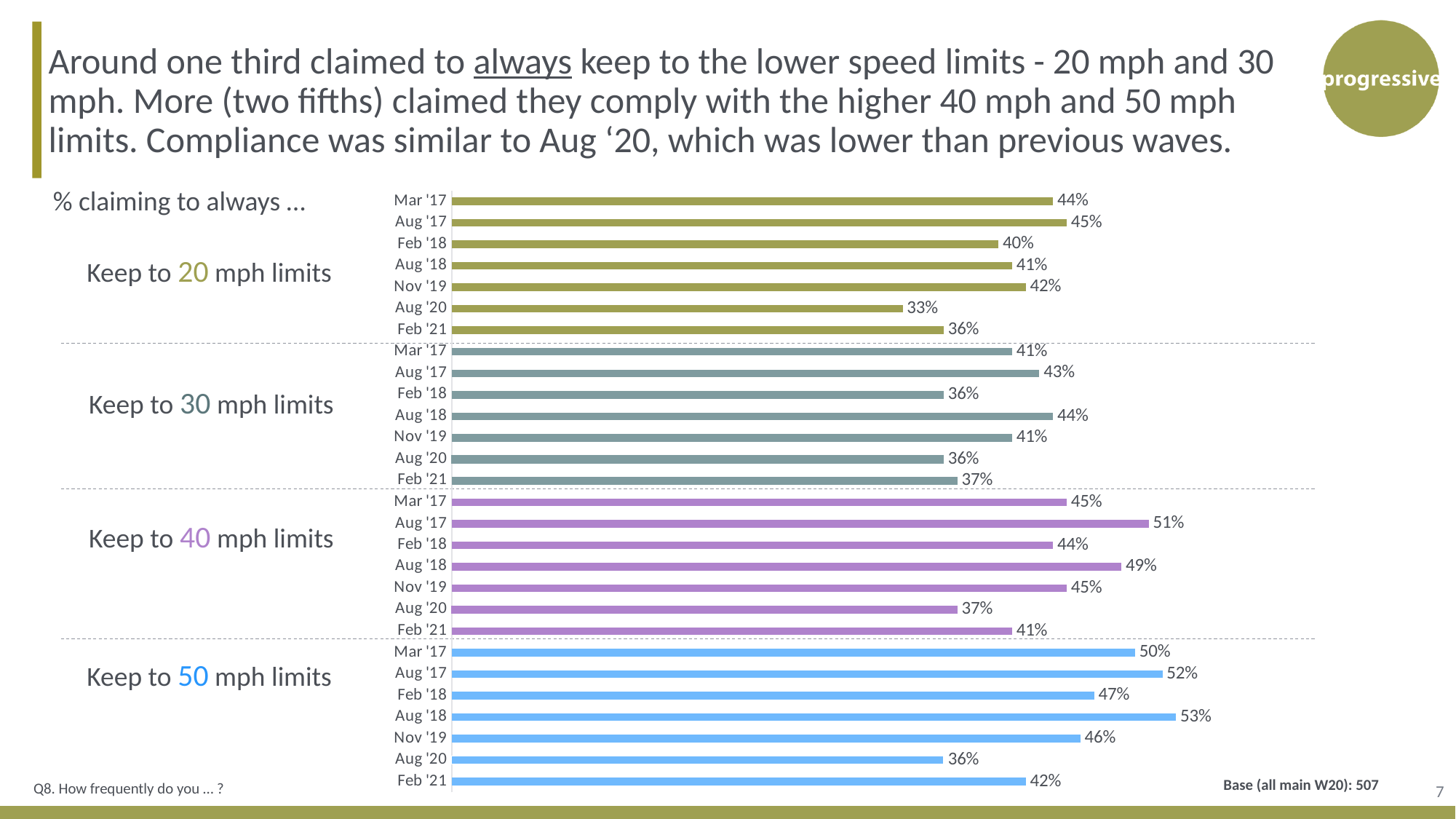
How many waves (time points) are shown for each speed limit group? 7 What colour are the bars for the 'Keep to 50 mph limits' group? Blue What percentage claimed to always keep to 50 mph limits in Aug '18? 53% How many speed limit groups are shown in the chart? 4 What percentage claimed to always keep to 40 mph limits in Aug '20? 37% Which wave has the lowest value for keeping to 20 mph limits? Aug '20 What is the difference between the Aug '17 and Aug '20 values for keeping to 50 mph limits? 16% Which is larger: the Feb '21 value for keeping to 30 mph limits or the Feb '21 value for keeping to 40 mph limits? Keep to 40 mph limits What percentage claimed to always keep to 20 mph limits in Feb '21? 36% Which wave has the highest value for keeping to 40 mph limits? Aug '17 What is the difference between the Mar '17 and Feb '18 values for keeping to 30 mph limits? 5% What kind of chart is shown on the slide? Bar chart